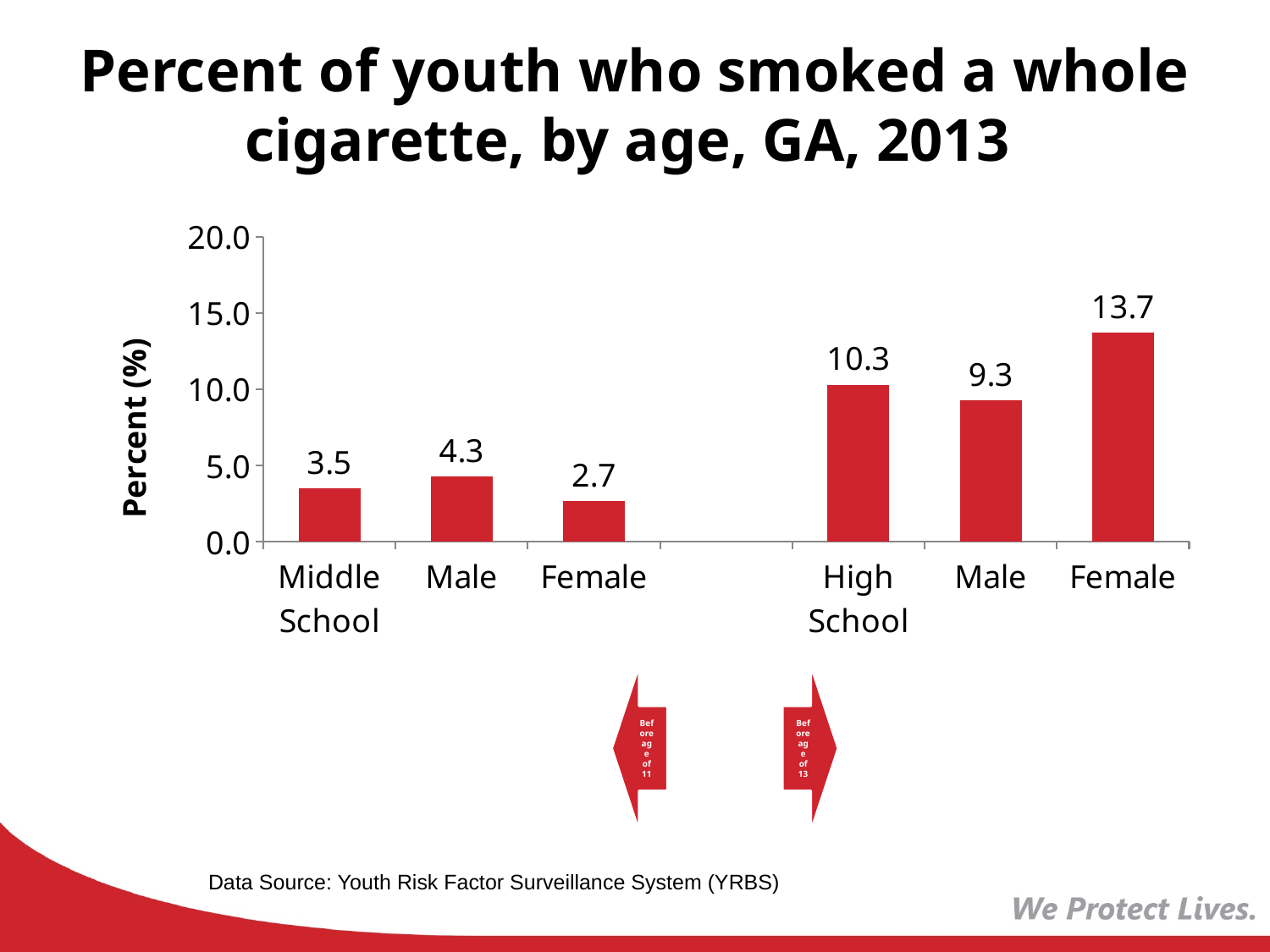
What kind of chart is shown on the slide? Bar chart Which category has the lowest value? Female (Middle School) What is the value for Female in the high school group? 13.7 How many bars are plotted in the chart? 6 What is the value for High School overall? 10.3 Which category has the highest value? Female (High School) What is the value for Male in the middle school group? 4.3 What is the difference between the high school Female value and the high school Male value? 4.4 What is the label of the y axis? Percent (%) Which is larger: the Male value in the middle school group or the Female value in the middle school group? Male What is the value for Middle School overall? 3.5 What is the difference between the High School overall value and the Middle School overall value? 6.8